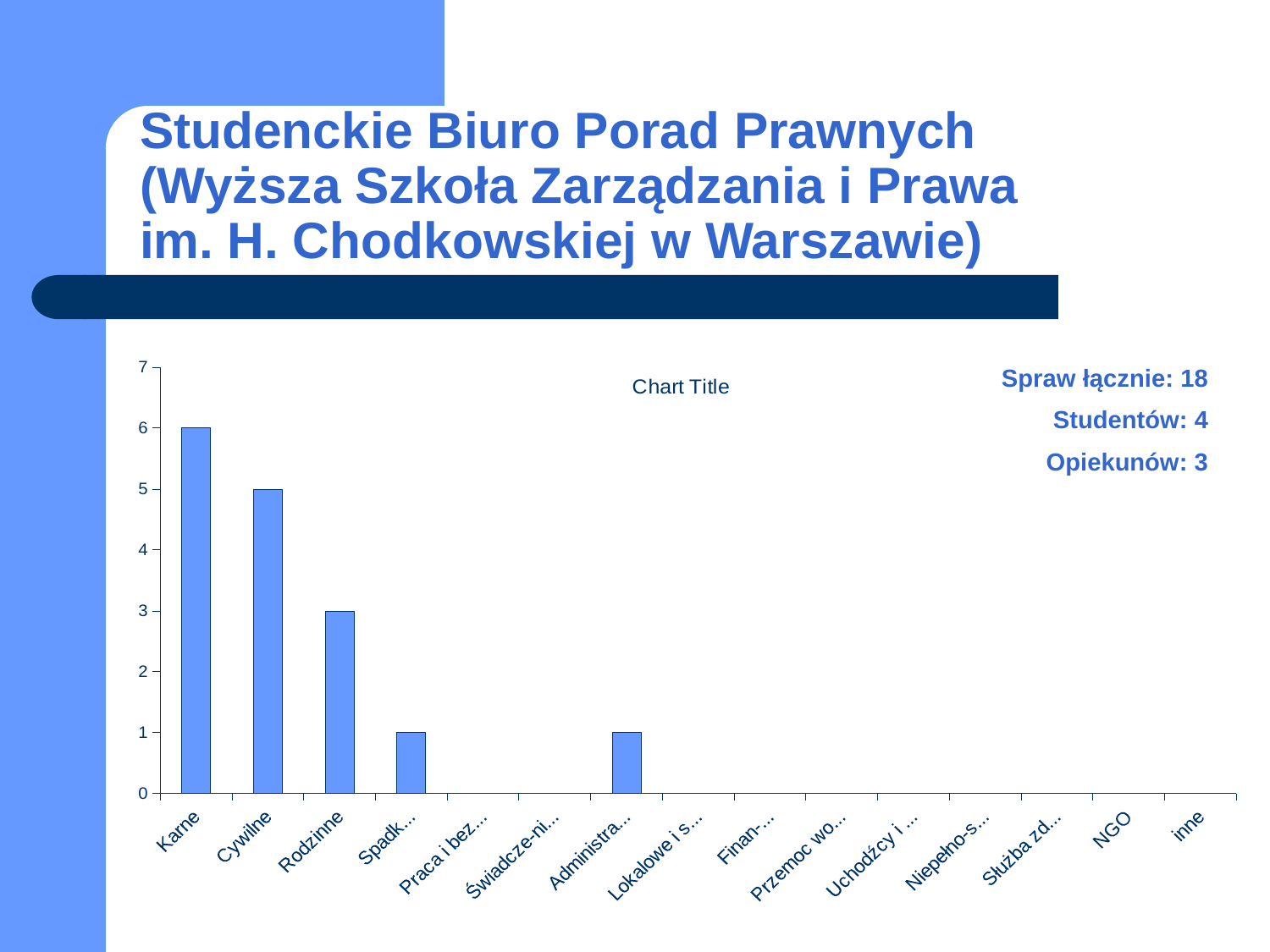
What kind of chart is shown on the slide? bar chart What is the title shown on the chart? Chart Title What is the value for Karne? 6 What is the value for Cywilne? 5 Do the values rise or fall from Karne to Rodzinne? fall Which is larger, the value for Cywilne or the value for Rodzinne? Cywilne How many categories are shown on the x axis? 15 Which category has the highest value? Karne What is the value for Rodzinne? 3 What is the difference between the values for Karne and Rodzinne? 3 What is the difference between the values for Karne and Cywilne? 1 Is the value for Karne greater or less than 4? greater